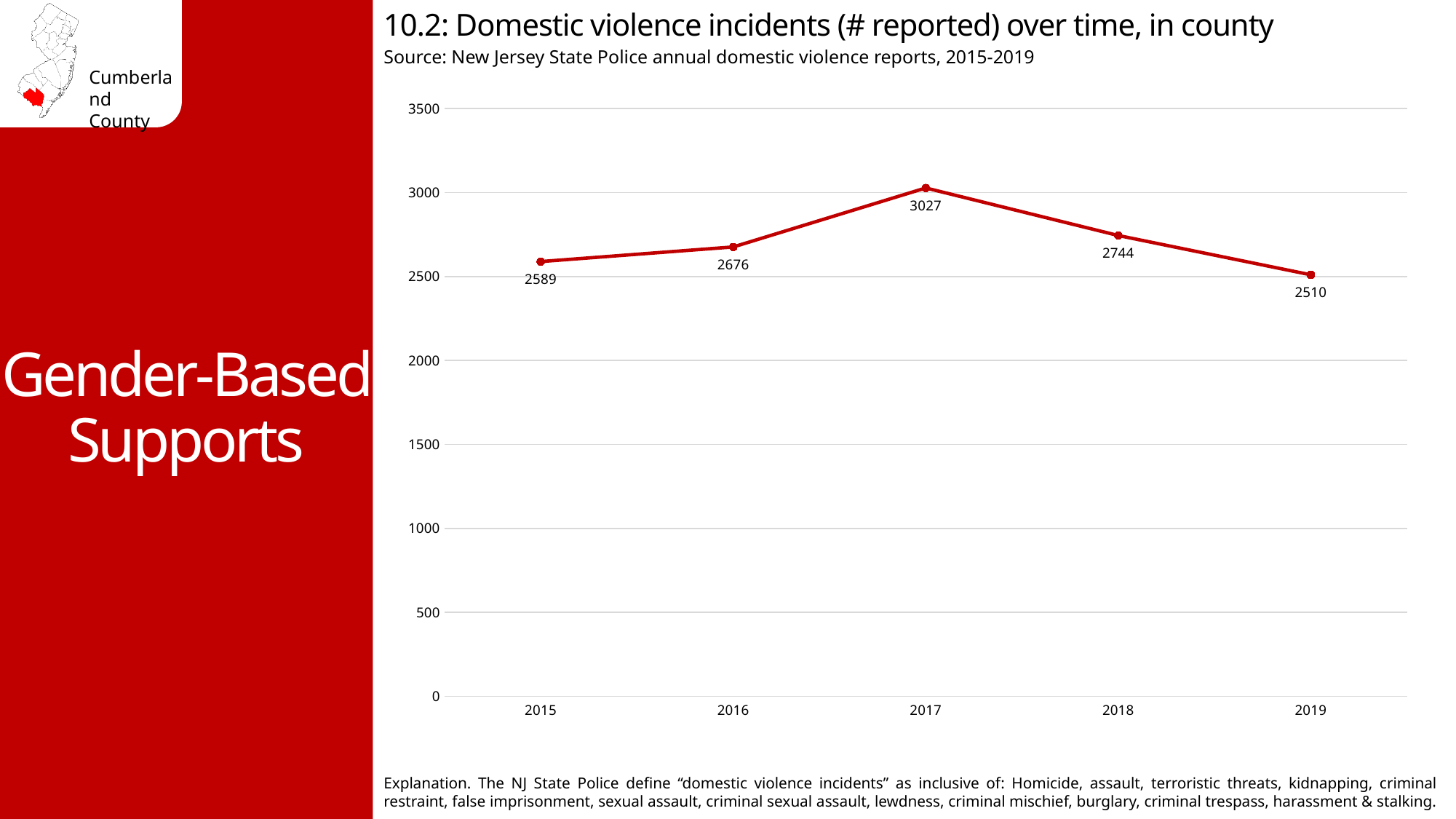
What was the number of domestic violence incidents reported in 2019? 2510 What is the difference between the number of incidents in 2017 and in 2019? 517 Did the number of reported incidents rise or fall from 2017 to 2019? fall What was the number of domestic violence incidents reported in 2017? 3027 What was the number of domestic violence incidents reported in 2015? 2589 Which year had the highest number of reported domestic violence incidents? 2017 How many years are plotted on the chart? 5 Which year had the lowest number of reported domestic violence incidents? 2019 What kind of chart is shown on the slide? line chart Which year had more reported incidents, 2016 or 2018? 2018 Is the value for 2018 greater or less than 3000? less What is the difference between the number of incidents in 2016 and in 2015? 87